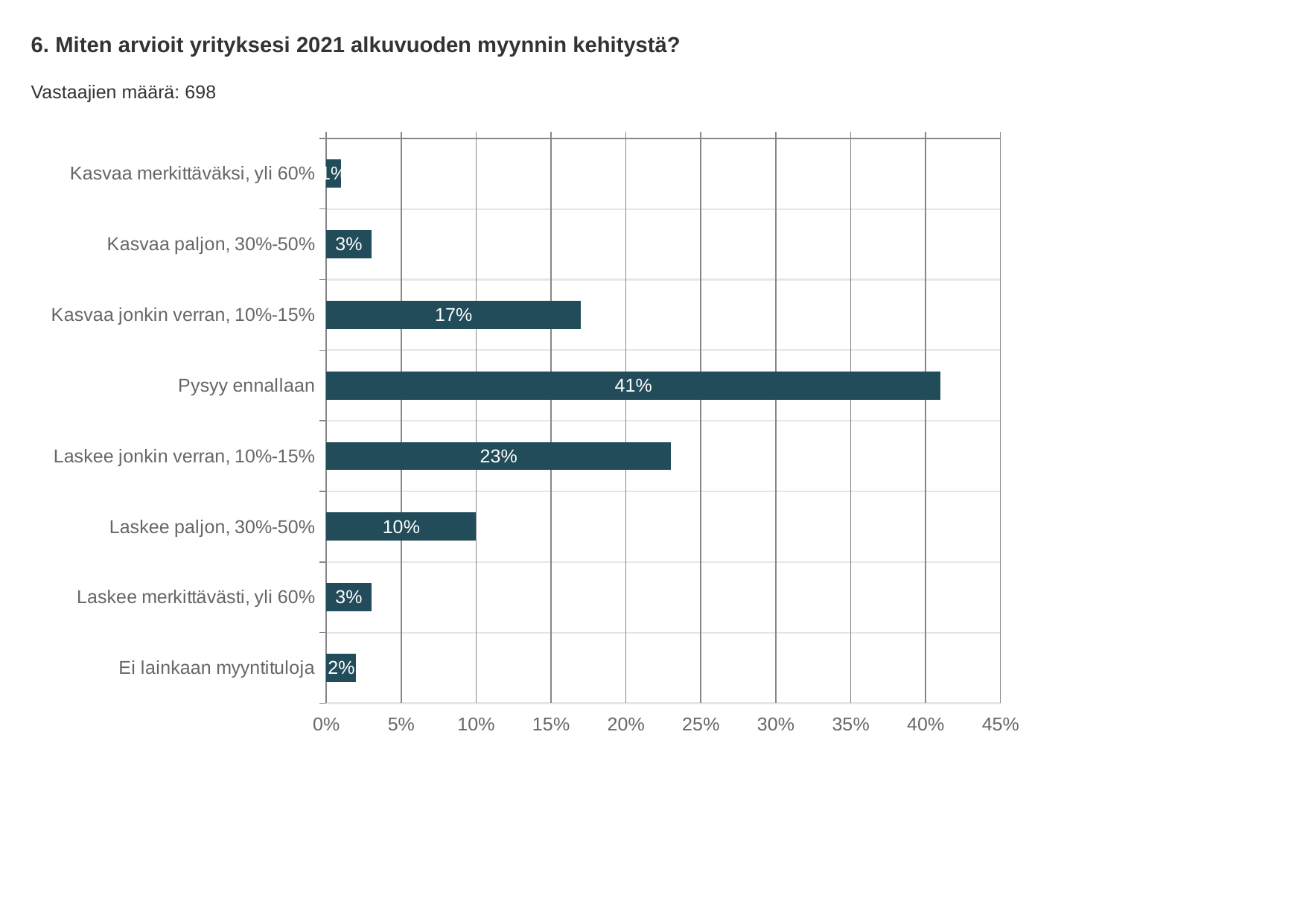
How many categories are shown in the chart? 8 Which category has the lowest value? Kasvaa merkittäväksi, yli 60% What kind of chart is shown on the slide? Bar chart What is the value for "Laskee jonkin verran, 10%-15%"? 23% Which category has the highest value? Pysyy ennallaan What is the difference between "Pysyy ennallaan" and "Laskee jonkin verran, 10%-15%"? 18% What is the value for "Kasvaa jonkin verran, 10%-15%"? 17% Which is larger, "Kasvaa jonkin verran, 10%-15%" or "Laskee jonkin verran, 10%-15%"? Laskee jonkin verran, 10%-15% How many respondents (Vastaajien määrä) are reported on the slide? 698 What is the value for "Pysyy ennallaan"? 41% Is the value for "Pysyy ennallaan" greater or less than 40%? greater What is the value for "Laskee paljon, 30%-50%"? 10%